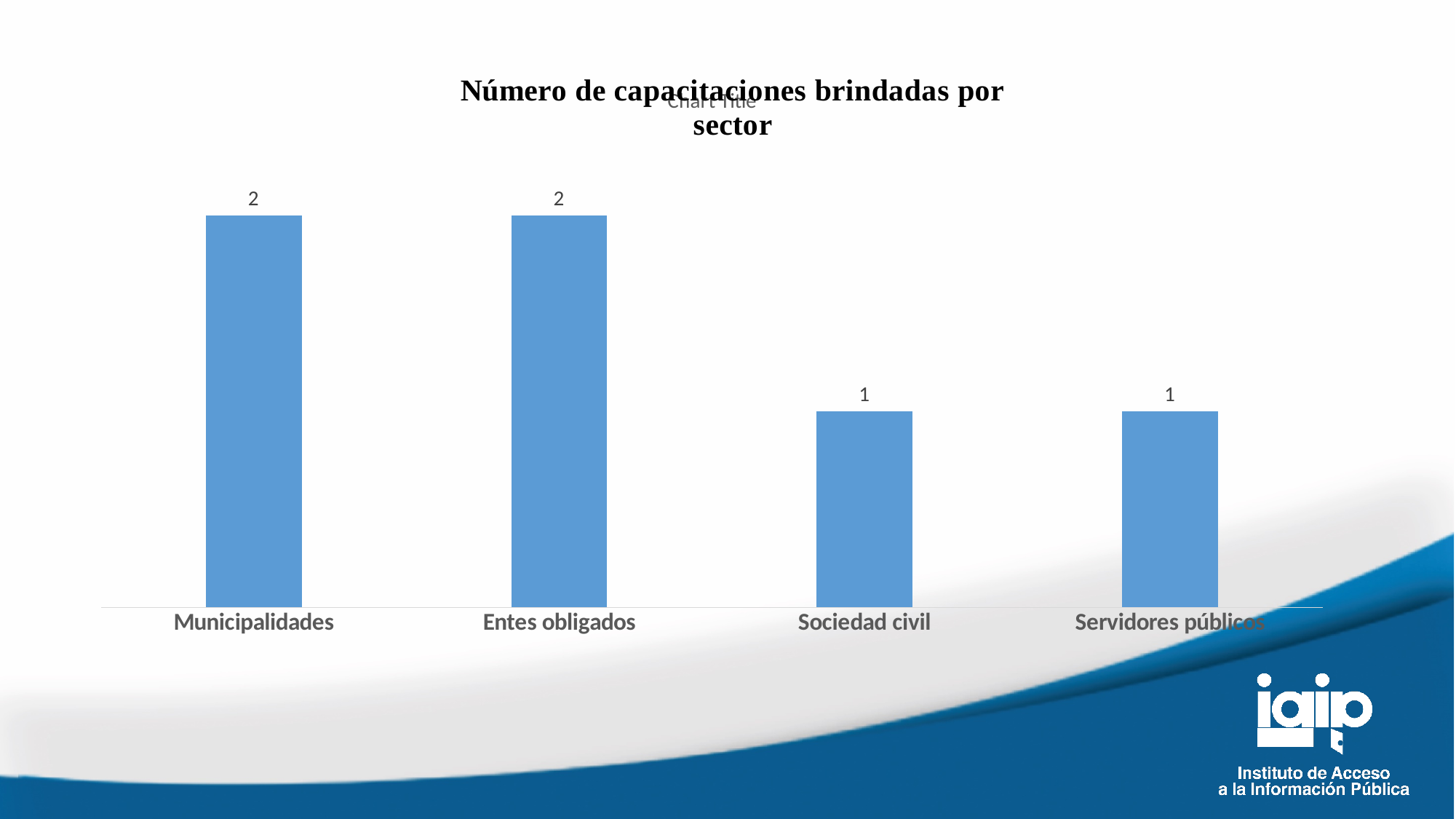
What is the value for Sociedad civil? 1 How many categories are shown on the x axis? 4 Which is larger, the value for Entes obligados or the value for Servidores públicos? Entes obligados What is the value for Entes obligados? 2 Do the values rise or fall from Municipalidades to Servidores públicos along the x axis? Fall What is the title of the chart? Número de capacitaciones brindadas por sector What is the value for Servidores públicos? 1 What is the total of all four bars? 6 What is the difference between the values for Municipalidades and Sociedad civil? 1 What colour are the bars in the chart? Blue What kind of chart is shown on the slide? Bar chart What is the value for Municipalidades? 2